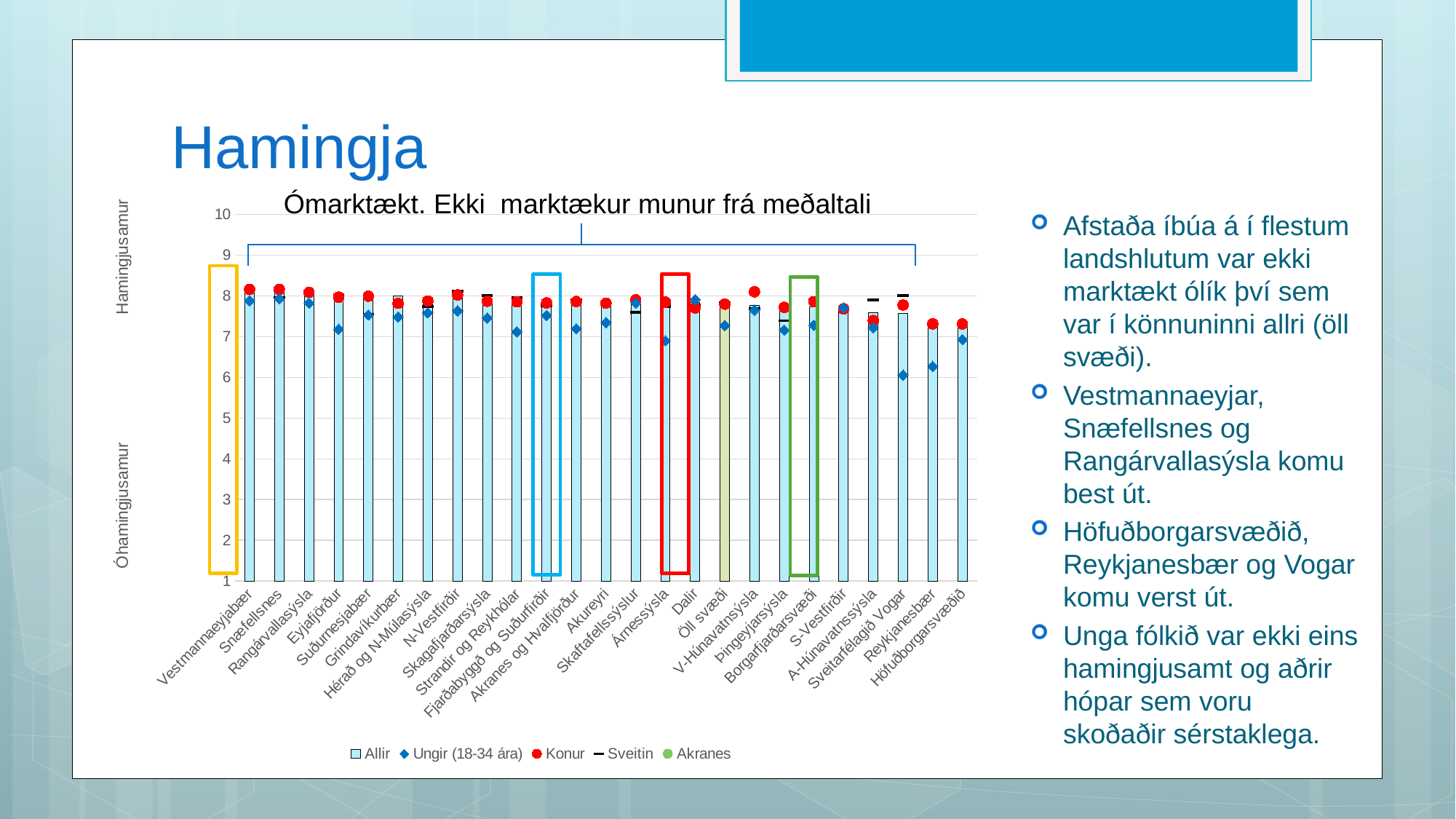
How many series does the chart legend list? 5 Do the Allir bar values generally rise or fall from left to right along the x axis? fall Is the Ungir (18-34 ára) value for Dalir greater or less than 7? greater Which series in the legend is shown with red circle markers? Konur Which is larger: the Ungir (18-34 ára) value for Vestmannaeyjabær or for Sveitarfélagið Vogar? Vestmannaeyjabær Is the Allir value for Höfuðborgarsvæðið greater or less than 8? less How many categories are shown along the x axis of the chart? 25 What kind of chart is shown on the slide? bar chart Is the Konur value for Vestmannaeyjabær greater or less than 8? greater Which is larger: the Allir value for Snæfellsnes or for Höfuðborgarsvæðið? Snæfellsnes